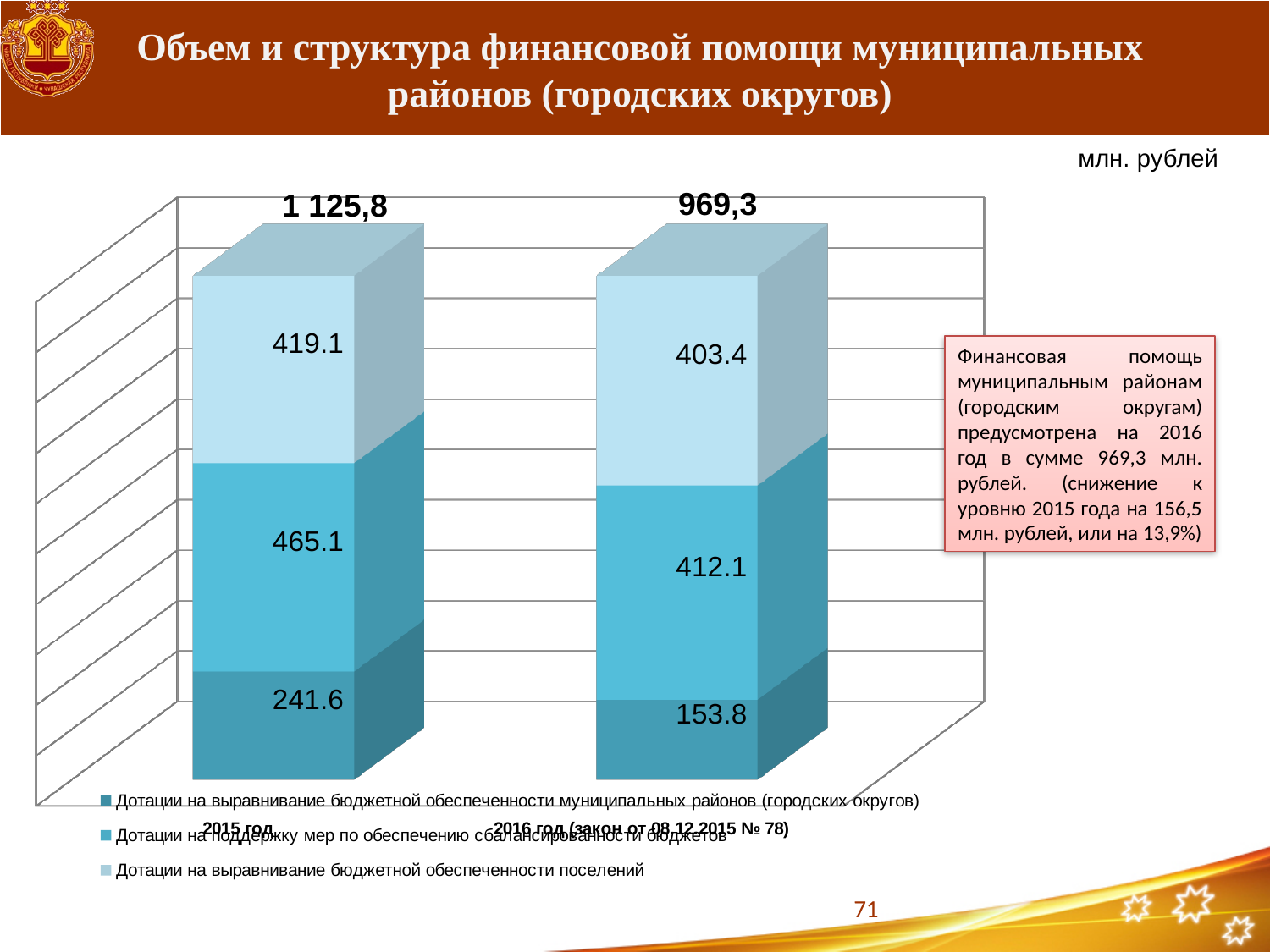
How many series does the legend list? 3 What is the value of 'Дотации на выравнивание бюджетной обеспеченности муниципальных районов (городских округов)' for 2015 год? 241.6 What is the value of 'Дотации на выравнивание бюджетной обеспеченности поселений' for 2016 год? 403.4 What is the total value of the stacked bar for 2016 год (закон от 08.12.2015 № 78)? 969,3 Which year has the larger value for 'Дотации на поддержку мер по обеспечению сбалансированности бюджетов', 2015 or 2016? 2015 год In what units are the chart values expressed? млн. рублей What is the total value of the stacked bar for 2015 год? 1 125,8 What is the value of 'Дотации на поддержку мер по обеспечению сбалансированности бюджетов' for 2016 год? 412.1 Does the total financial assistance rise or fall from 2015 to 2016? Fall How many categories (years) are shown on the x axis? 2 What type of chart is shown on the slide? Stacked bar chart What is the difference between the 2015 and 2016 values of 'Дотации на выравнивание бюджетной обеспеченности муниципальных районов (городских округов)'? 87.8